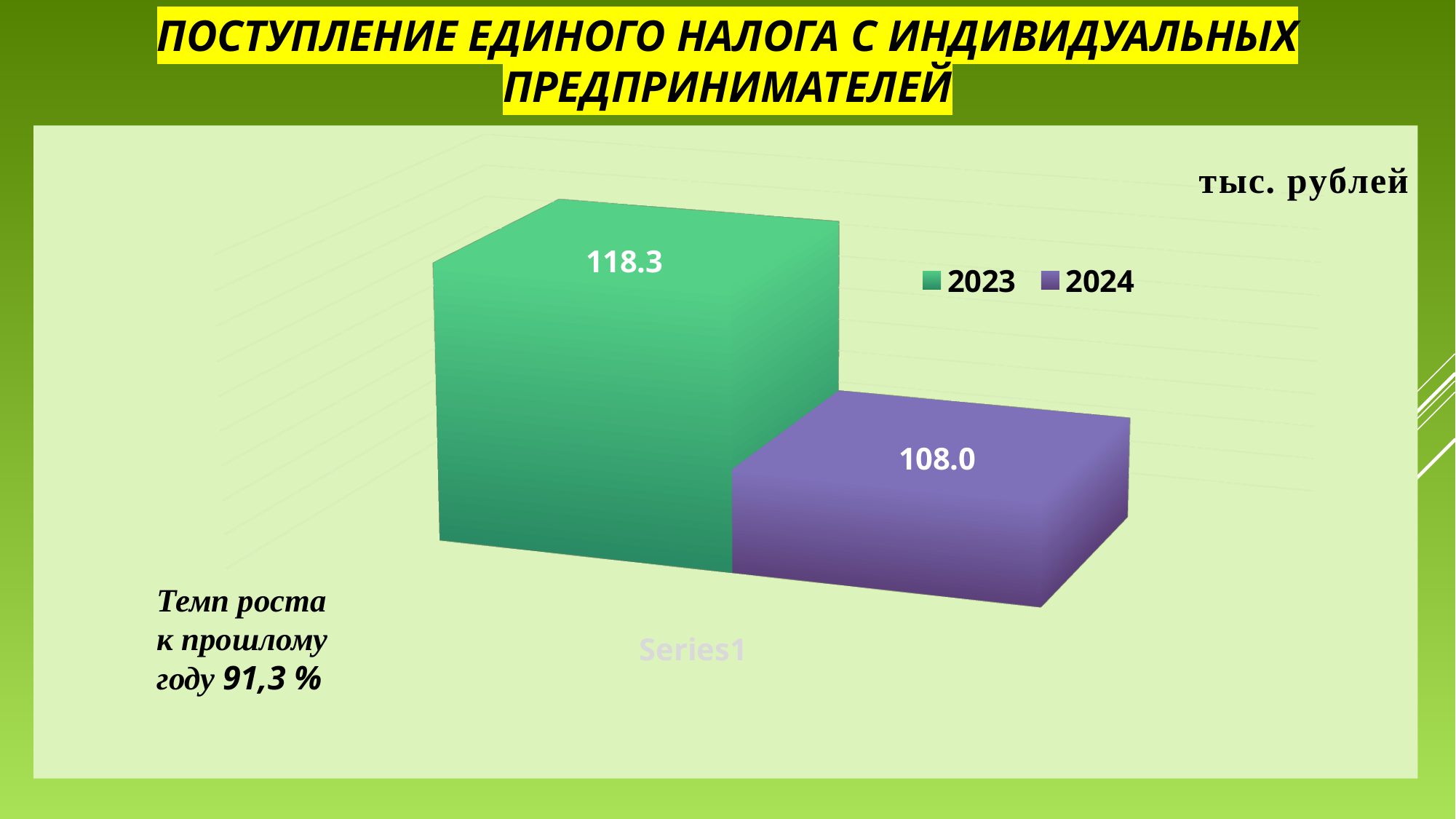
How many series does the legend list? 2 What is the difference between the 2023 and 2024 values? 10.3 What unit is stated for the chart values? тыс. рублей Which year has the higher value, 2023 or 2024? 2023 What kind of chart is shown on the slide? bar chart What growth rate to the previous year is stated on the slide? 91,3 % Which series has the lowest value? 2024 What is the value for 2024? 108.0 Do the values rise or fall from 2023 to 2024? fall What is the value for 2023? 118.3